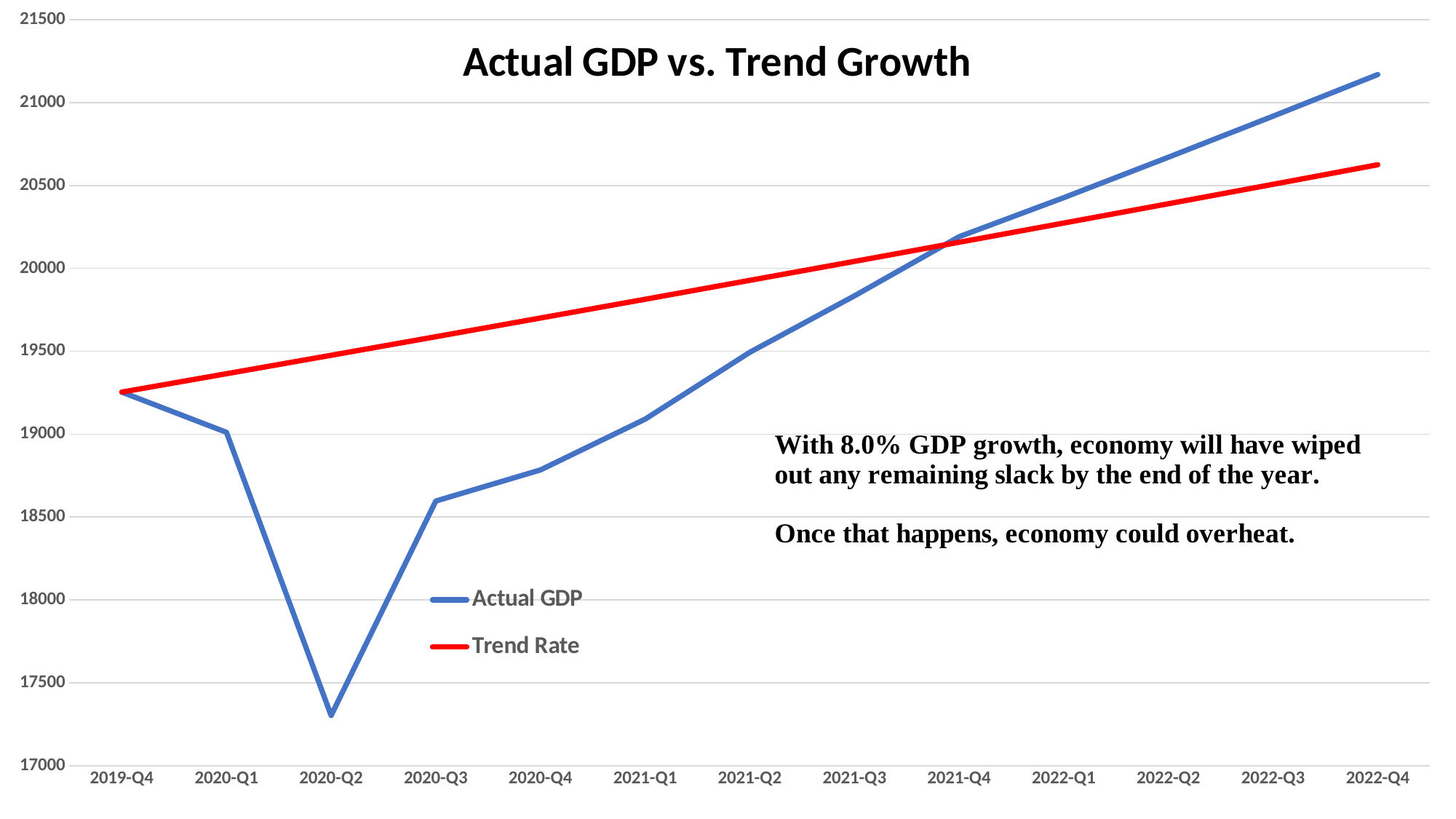
Is the value for Trend Rate in 2019-Q4 greater or less than 19500? less In 2022-Q4, which is larger: Actual GDP or Trend Rate? Actual GDP In 2020-Q2, which is larger: Actual GDP or Trend Rate? Trend Rate What kind of chart is shown on the slide? Line chart Does the Trend Rate line rise or fall from 2019-Q4 to 2022-Q4? Rise In which quarter is Actual GDP at its highest? 2022-Q4 How many series does the legend list? 2 Is the value for Actual GDP in 2022-Q4 greater or less than 21000? greater How many quarters are plotted along the x axis? 13 In which quarter is Actual GDP at its lowest? 2020-Q2 Is the value for Actual GDP in 2020-Q2 greater or less than 17500? less